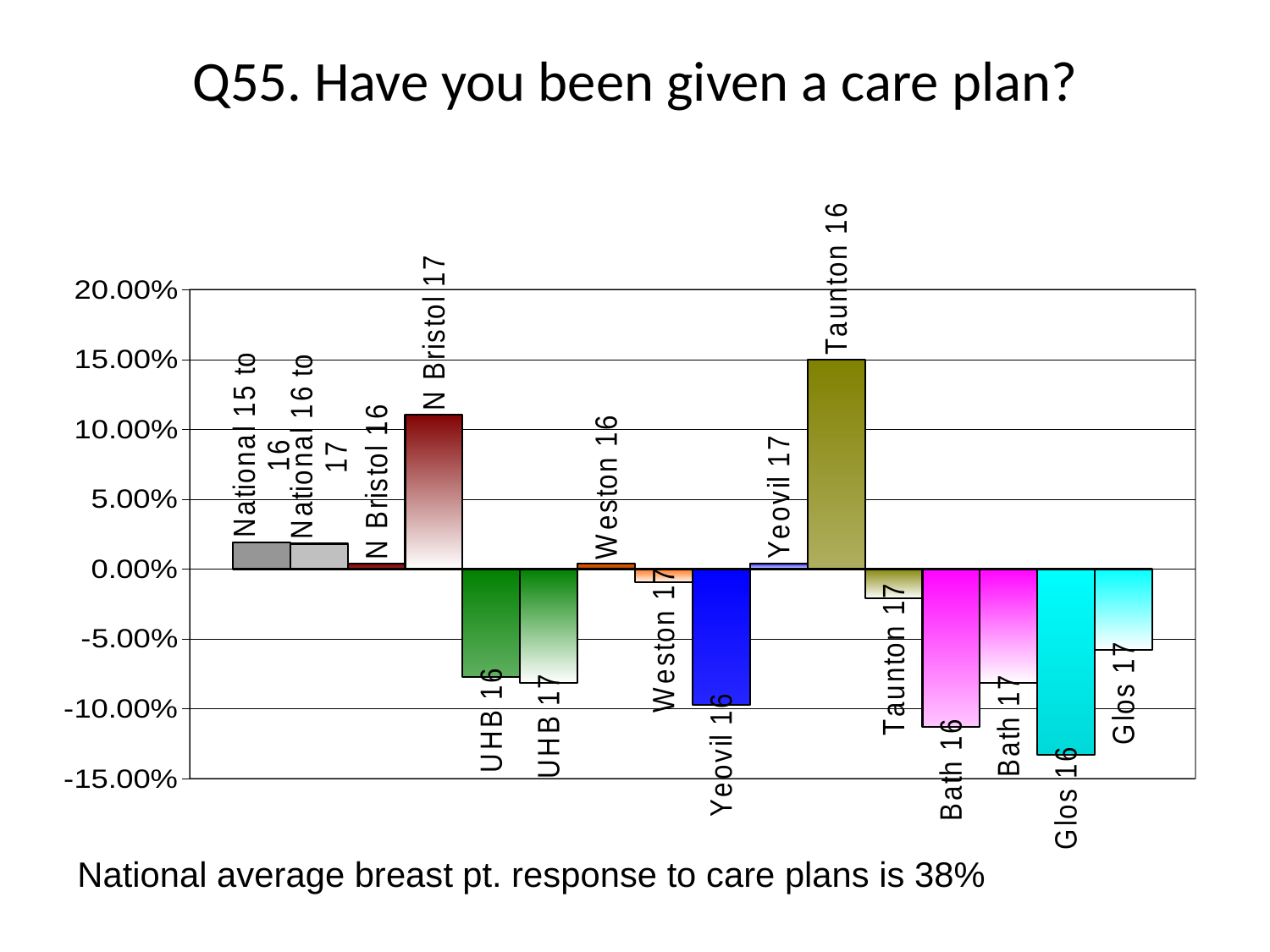
Is the value for Bath 16 greater or less than -10.00%? less Is the value for Glos 16 greater or less than -10.00%? less How many bars (categories) are plotted in the chart? 16 Which category has the lowest value in the chart? Glos 16 Which category has the highest value in the chart? Taunton 16 What kind of chart is shown on the slide? bar chart Which is larger, the value for Glos 17 or the value for Glos 16? Glos 17 What is the title of the chart on the slide? Q55. Have you been given a care plan? Is the value for Yeovil 16 greater or less than -5.00%? less Which is larger, the value for N Bristol 17 or the value for Taunton 16? Taunton 16